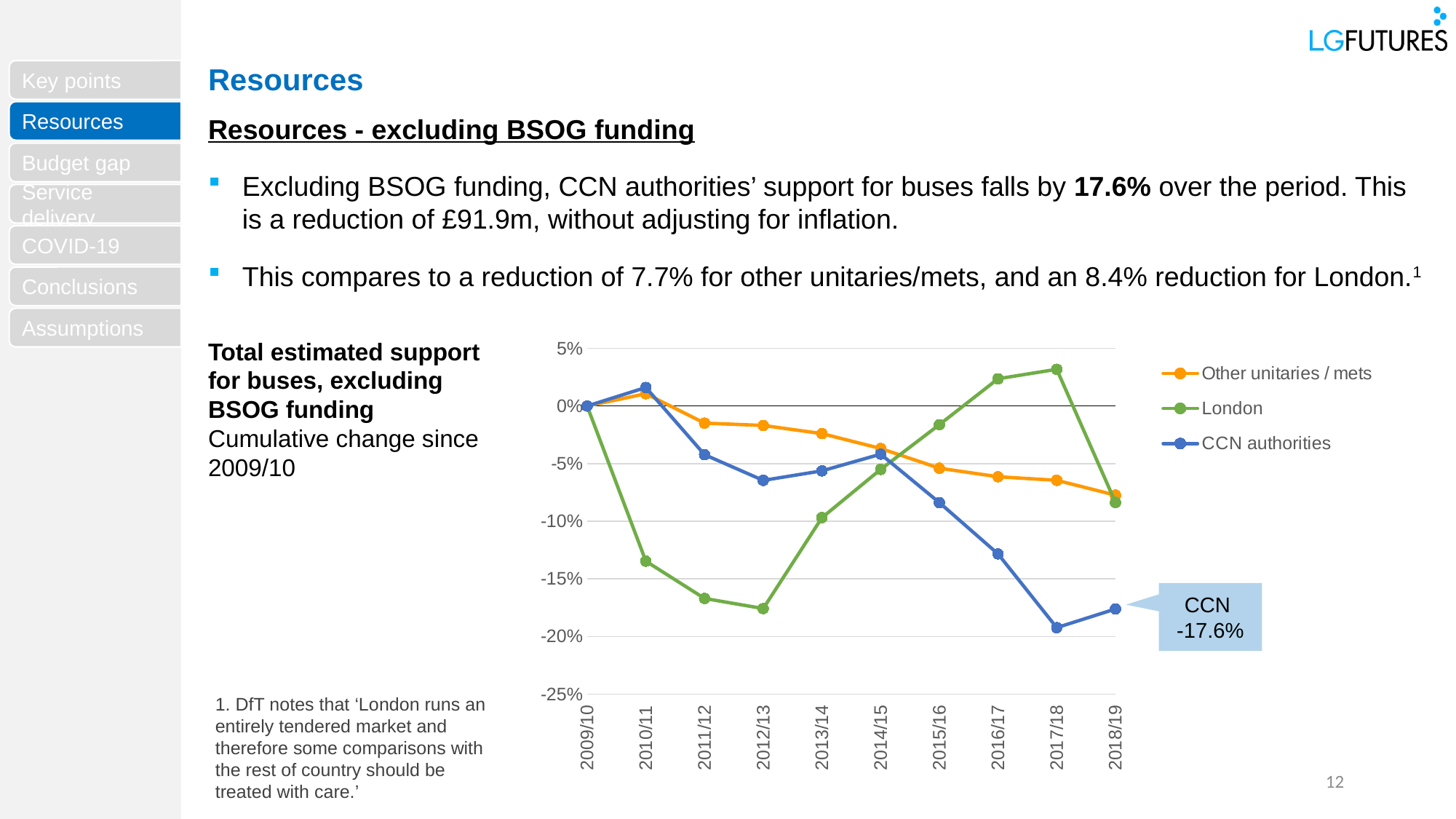
In which year does the CCN authorities line reach its lowest point? 2017/18 Is the value for London in 2016/17 greater or less than 0%? greater Does the Other unitaries / mets line generally rise or fall from 2010/11 to 2018/19? Fall How many series does the chart legend list? 3 Which series has the lowest value in 2012/13? London Is the value for Other unitaries / mets in 2018/19 greater or less than -10%? greater What kind of chart is shown on the slide? Line chart In 2017/18, which is higher: London or CCN authorities? London Is the value for London in 2012/13 greater or less than -15%? less How many years are shown along the x axis of the chart? 10 What is the cumulative change for CCN authorities in 2018/19 according to the chart callout? -17.6% Which series has the lowest value in 2018/19? CCN authorities